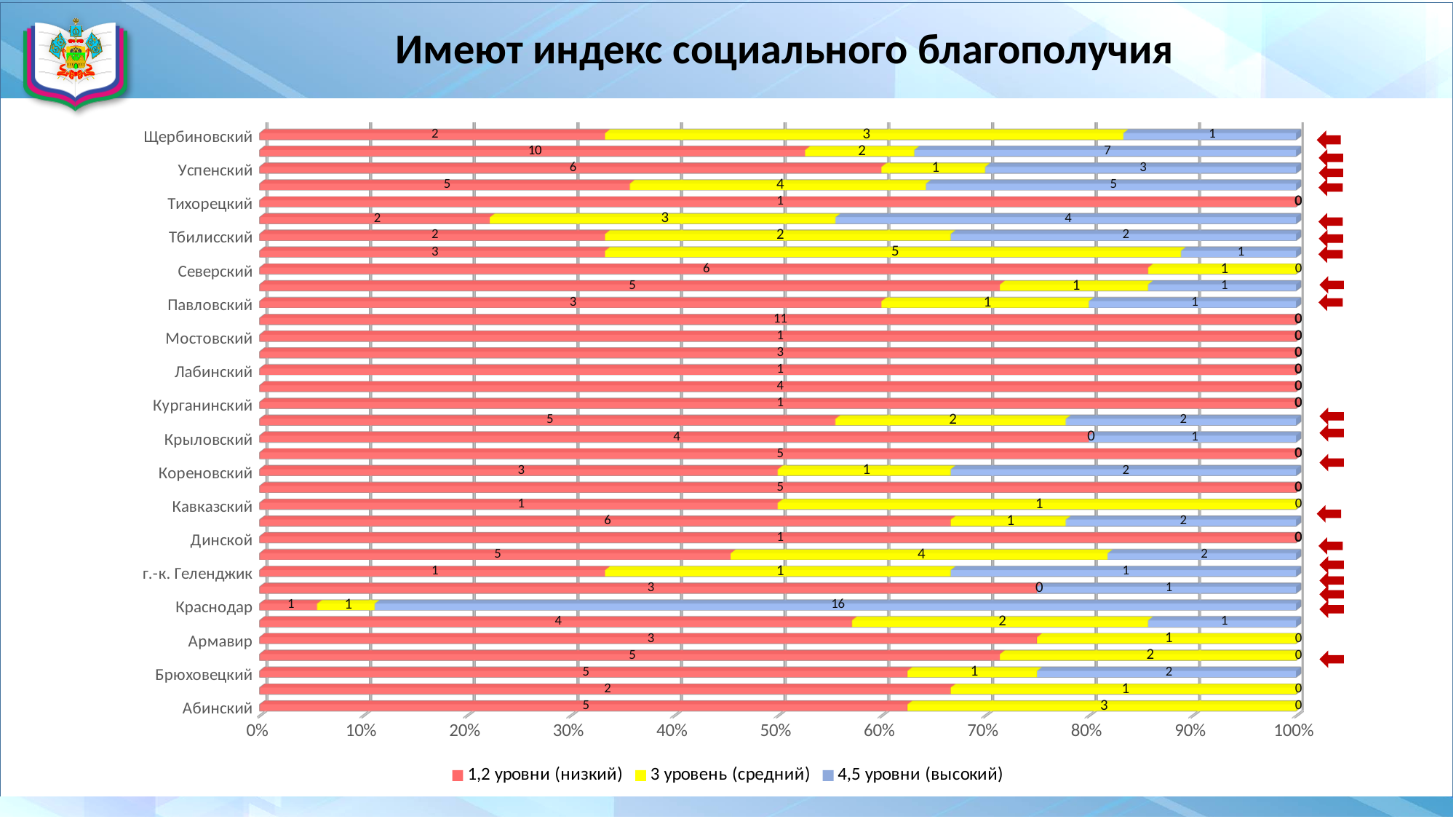
What is the value of the '4,5 уровни (высокий)' series for Краснодар? 16 What is the value of the '1,2 уровни (низкий)' series for Успенский? 6 What is the total of all three series for Краснодар? 18 What is the difference between the '4,5 уровни (высокий)' values for Краснодар and Кореновский? 14 What kind of chart is shown on the slide? bar chart What is the total of all three series for Тбилисский? 6 How many series does the legend list? 3 What is the value of the '4,5 уровни (высокий)' series for Брюховецкий? 2 What is the value of the '3 уровень (средний)' series for Щербиновский? 3 Is the share of the '1,2 уровни (низкий)' segment for Северский greater or less than 80%? greater Which has the larger '4,5 уровни (высокий)' value, Краснодар or Щербиновский? Краснодар Which series is shown in red in the legend? 1,2 уровни (низкий)